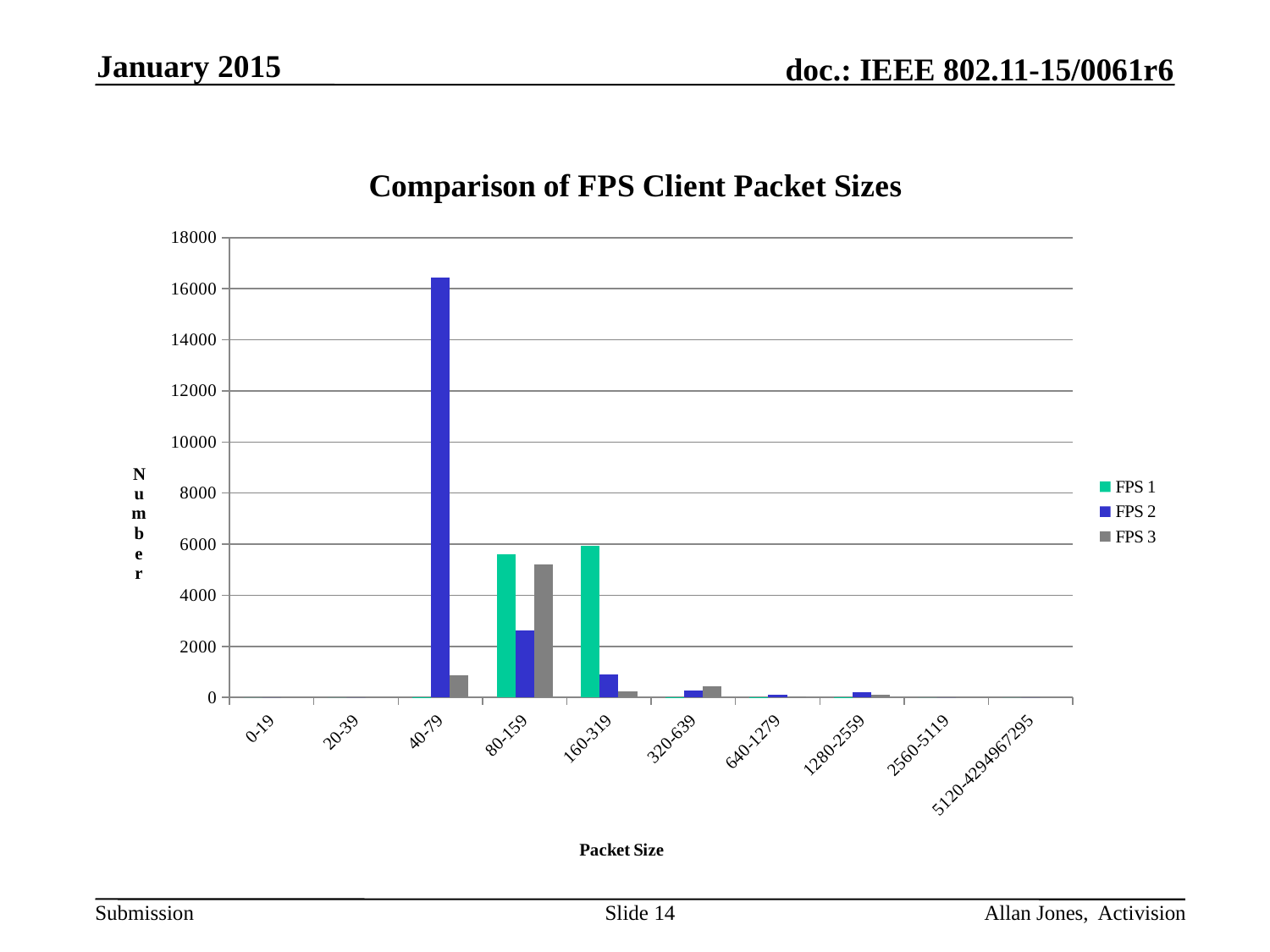
In the 80-159 category, which is larger: FPS 1 or FPS 2? FPS 1 What is the label of the x axis? Packet Size Which packet size category has the highest value for FPS 2? 40-79 Is the value for FPS 1 in the 80-159 category greater or less than 4000? greater What kind of chart is shown on the slide? bar chart How many series does the legend list? 3 Is the value for FPS 2 in the 40-79 category greater or less than 16000? greater In the 160-319 category, which is larger: FPS 1 or FPS 3? FPS 1 Is the value for FPS 3 in the 40-79 category greater or less than 2000? less How many packet size categories are shown on the x axis? 10 What is the title of the chart? Comparison of FPS Client Packet Sizes